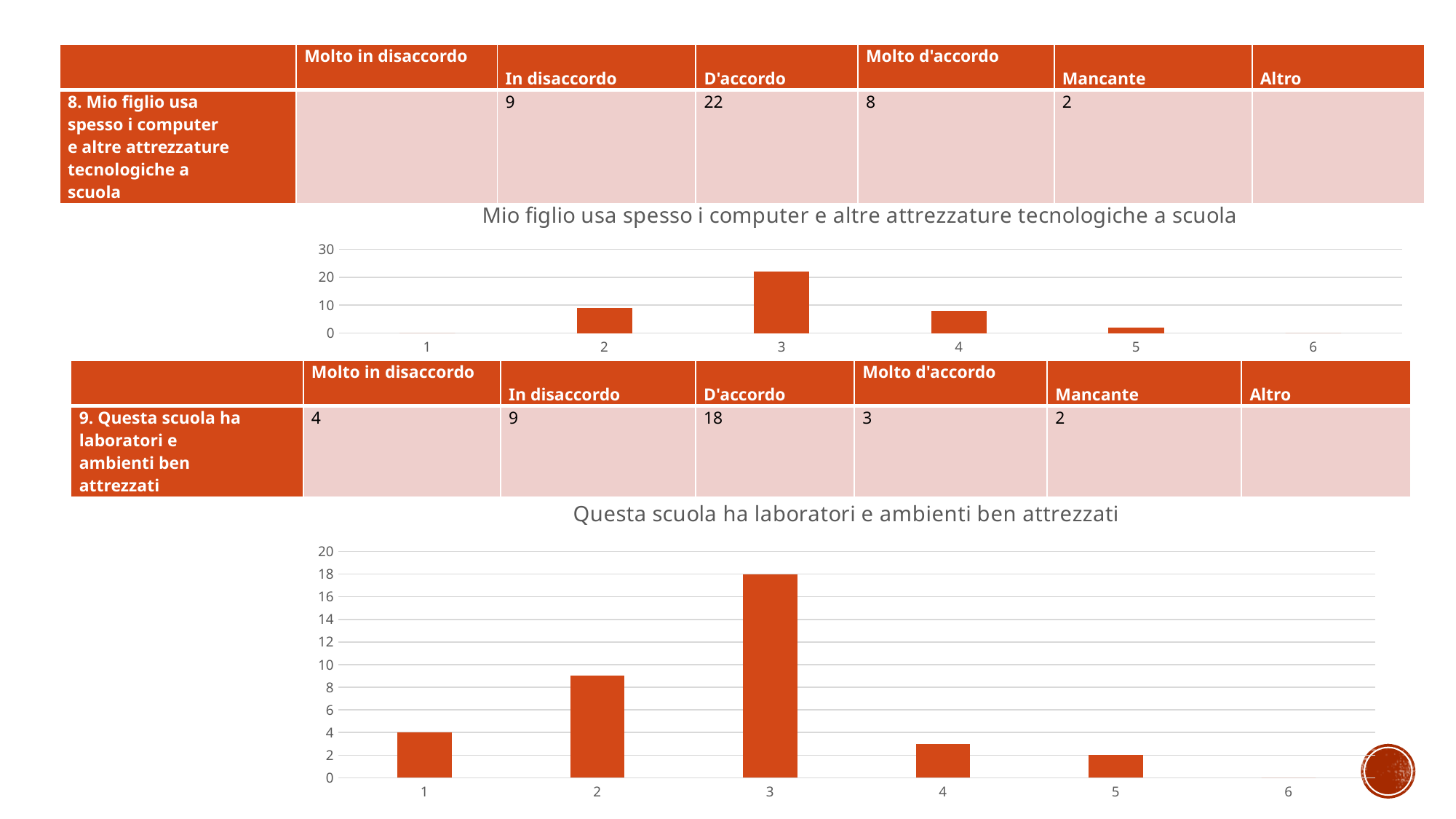
In the chart titled "Questa scuola ha laboratori e ambienti ben attrezzati", what is the value for category 1? 4 In the chart titled "Mio figlio usa spesso i computer e altre attrezzature tecnologiche a scuola", which category has the highest bar? 3 In the chart titled "Questa scuola ha laboratori e ambienti ben attrezzati", what is the difference between the values for category 2 and category 4? 6 In the chart titled "Mio figlio usa spesso i computer e altre attrezzature tecnologiche a scuola", what is the value for category 3? 22 How many category positions are shown on the x axis of the chart titled "Questa scuola ha laboratori e ambienti ben attrezzati"? 6 In the chart titled "Mio figlio usa spesso i computer e altre attrezzature tecnologiche a scuola", what is the difference between the values for category 3 and category 4? 14 In the chart titled "Questa scuola ha laboratori e ambienti ben attrezzati", what is the value for category 3? 18 In the chart titled "Mio figlio usa spesso i computer e altre attrezzature tecnologiche a scuola", is the value for category 2 greater or less than 10? less What kind of chart is the one titled "Questa scuola ha laboratori e ambienti ben attrezzati"? bar chart In the chart titled "Mio figlio usa spesso i computer e altre attrezzature tecnologiche a scuola", which is larger, the value for category 2 or category 5? category 2 In the chart titled "Questa scuola ha laboratori e ambienti ben attrezzati", which category has the highest bar? 3 In the chart titled "Questa scuola ha laboratori e ambienti ben attrezzati", is the value for category 2 greater or less than 8? greater